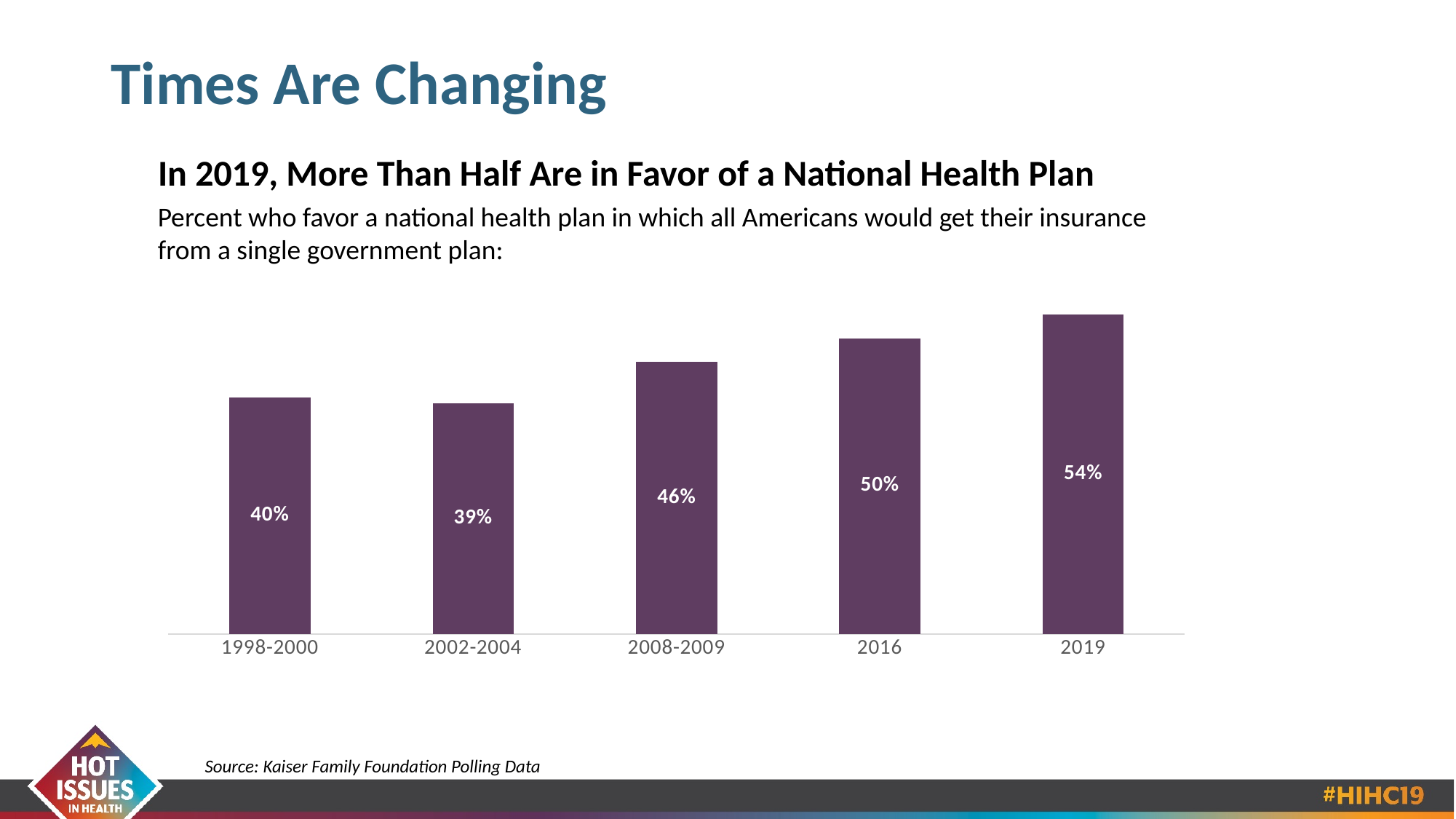
How many periods are shown on the x axis? 5 Which is larger, the value for 2016 or the value for 2002-2004? 2016 What percent favored a national health plan in 2019? 54% What kind of chart is shown on the slide? Bar chart What is the title of the chart? In 2019, More Than Half Are in Favor of a National Health Plan Which period has the highest percent in favor? 2019 What is the value shown for 1998-2000? 40% What is the difference between the 2016 value and the 2008-2009 value? 4% What is the value shown for 2008-2009? 46% What is the difference between the 2019 value and the 1998-2000 value? 14% Which period has the lowest percent in favor? 2002-2004 Do the values generally rise or fall from 2002-2004 to 2019? Rise